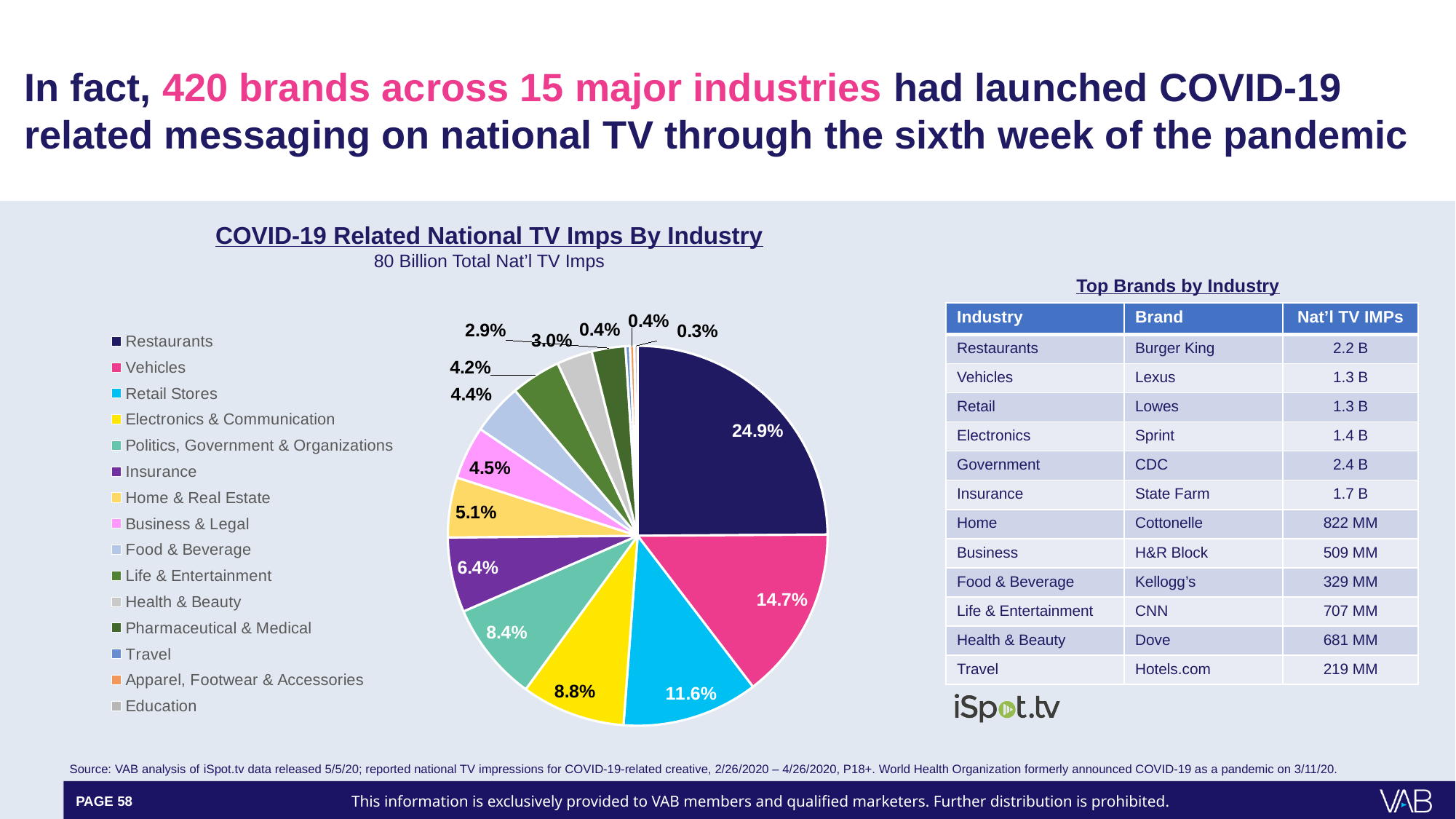
How many industries are listed in the pie chart's legend? 15 According to the chart's subtitle, what is the total number of national TV impressions represented? 80 Billion Total Nat'l TV Imps What percentage does the Insurance slice show in the pie chart? 6.4% What share of COVID-19 related national TV impressions does the Restaurants slice represent in the pie chart? 24.9% What percentage is shown for Vehicles in the pie chart? 14.7% Which industry has the smallest slice in the pie chart? Education What type of chart is used to show COVID-19 related national TV impressions by industry? Pie chart What is the title of the chart on the slide? COVID-19 Related National TV Imps By Industry Which slice is larger in the pie chart: Retail Stores or Electronics & Communication? Retail Stores What percentage is labelled for Retail Stores in the pie chart? 11.6% By how many percentage points does the Restaurants share exceed the Vehicles share in the pie chart? 10.2 percentage points Which industry has the largest slice in the pie chart? Restaurants